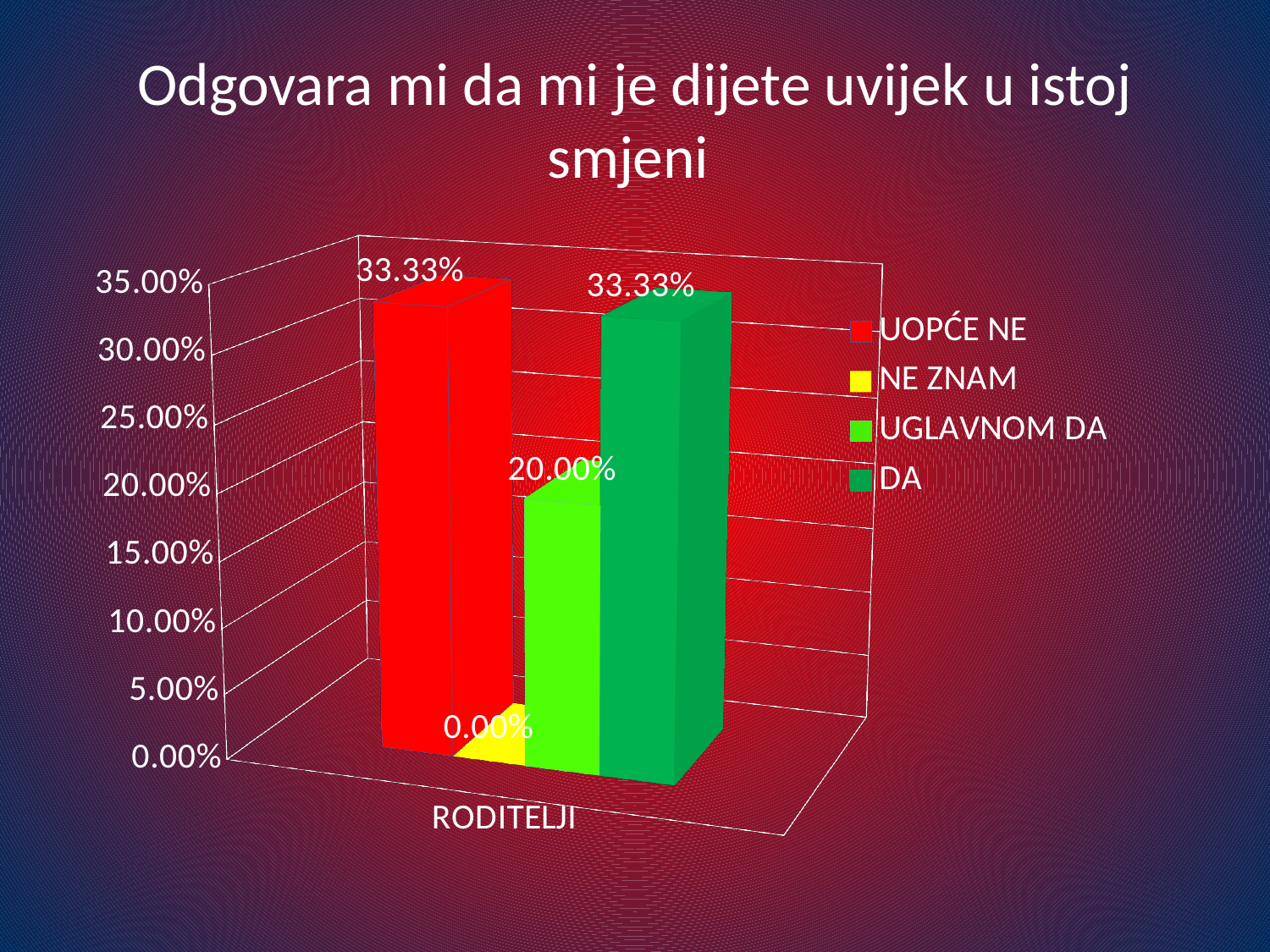
What kind of chart is shown on the slide? bar chart What is the value for UOPĆE NE? 33.33% How many series does the legend list? 4 What is the category label on the x axis? RODITELJI Is the value for UGLAVNOM DA greater or less than 25.00%? less Which series has the lowest value? NE ZNAM What is the difference between the values for DA and UGLAVNOM DA? 13.33% What colour is the bar for UOPĆE NE? red Which is larger, the value for UOPĆE NE or the value for UGLAVNOM DA? UOPĆE NE What is the value for UGLAVNOM DA? 20.00% What is the value for DA? 33.33% What is the value for NE ZNAM? 0.00%